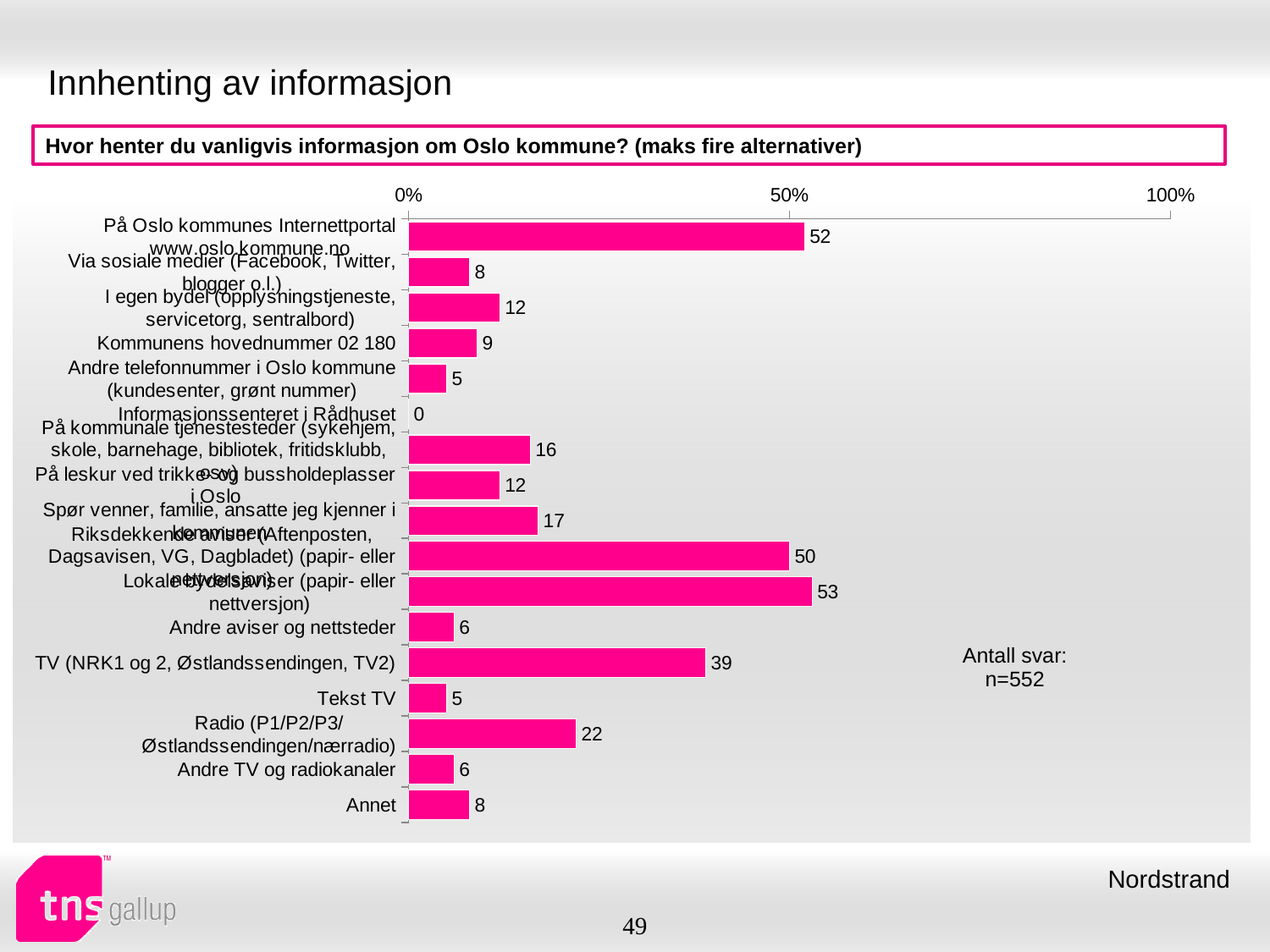
Which is larger: the value for "Radio (P1/P2/P3/Østlandssendingen/nærradio)" or the value for "Spør venner, familie, ansatte jeg kjenner i kommunen"? Radio (P1/P2/P3/Østlandssendingen/nærradio) What is the value for "Radio (P1/P2/P3/Østlandssendingen/nærradio)"? 22 What kind of chart is shown on the slide? bar chart Which category has the lowest value? Informasjonssenteret i Rådhuset How many categories are shown in the chart? 17 Which category has the highest value? Lokale bydelsaviser (papir- eller nettversjon) What is the number of respondents (n) stated on the slide? n=552 What is the value for "TV (NRK1 og 2, Østlandssendingen, TV2)"? 39 What is the value for "Tekst TV"? 5 What is the value for "Kommunens hovednummer 02 180"? 9 What is the difference between the values for "På Oslo kommunes Internettportal www.oslo.kommune.no" and "TV (NRK1 og 2, Østlandssendingen, TV2)"? 13